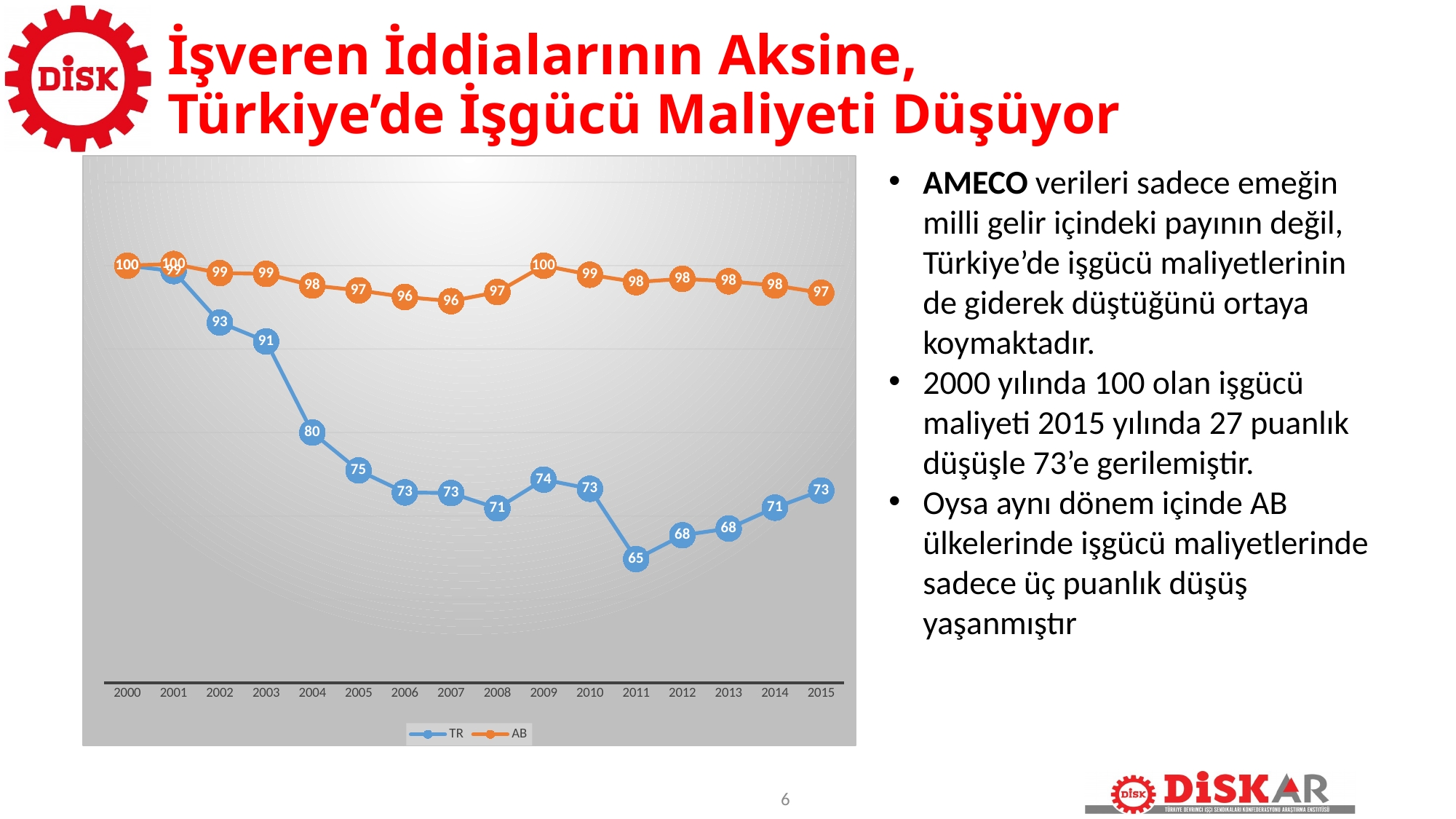
What is the value of the AB series in 2015? 97 In 2004, which series has the higher value, TR or AB? AB What is the value of the AB series in 2006? 96 What kind of chart is shown on the slide? Line chart In which year does the TR series reach its lowest value? 2011 By how much did the TR value rise from 2011 to 2015? 8 How many series does the legend list? 2 Does the TR series rise or fall from 2000 to 2005? Fall How many years are shown on the x axis? 16 What is the value of the TR series in 2009? 74 What is the value of the TR series in 2011? 65 What is the difference between the AB value and the TR value in 2015? 24